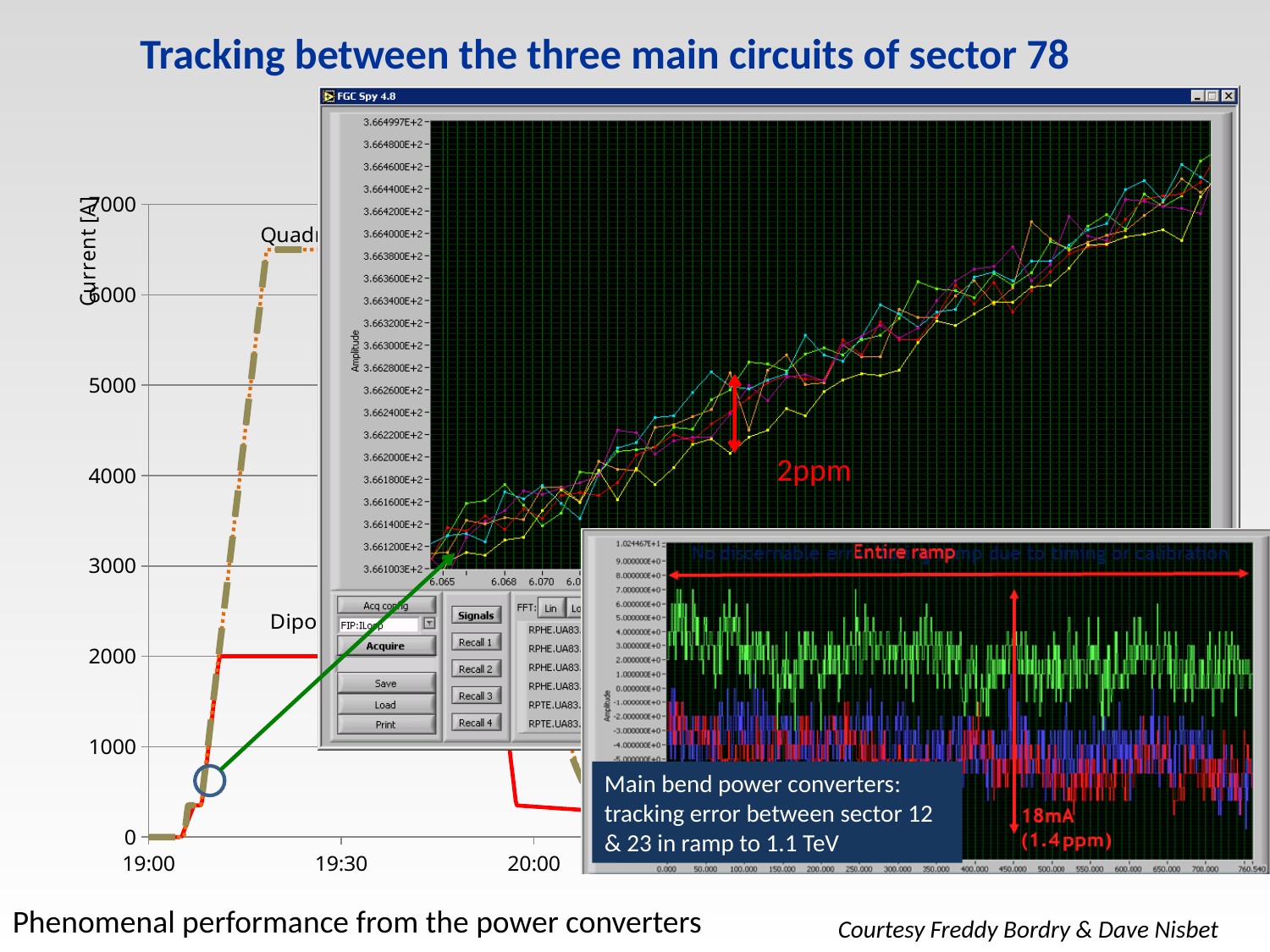
On the left chart, which line reaches a higher current, the dashed line or the solid red line? the dashed line On the left chart, is the plateau value of the solid red line greater or less than 3000? less On the left chart, what is the label of the y axis? Current [A] What tracking error value is annotated in red on the lower-right inset chart? 18mA (1.4ppm) On the left chart, is the plateau value of the dashed line greater or less than 6000? greater On the left chart, does the current rise or fall between 19:00 and 19:30? rise On the left chart, at what current does the solid red line plateau? 2000 On the left chart, is the value of the dashed line at 19:30 greater or less than 5000? greater How many time labels are shown on the x axis of the left chart? 3 What kind of chart is the large chart on the left of the slide? line chart